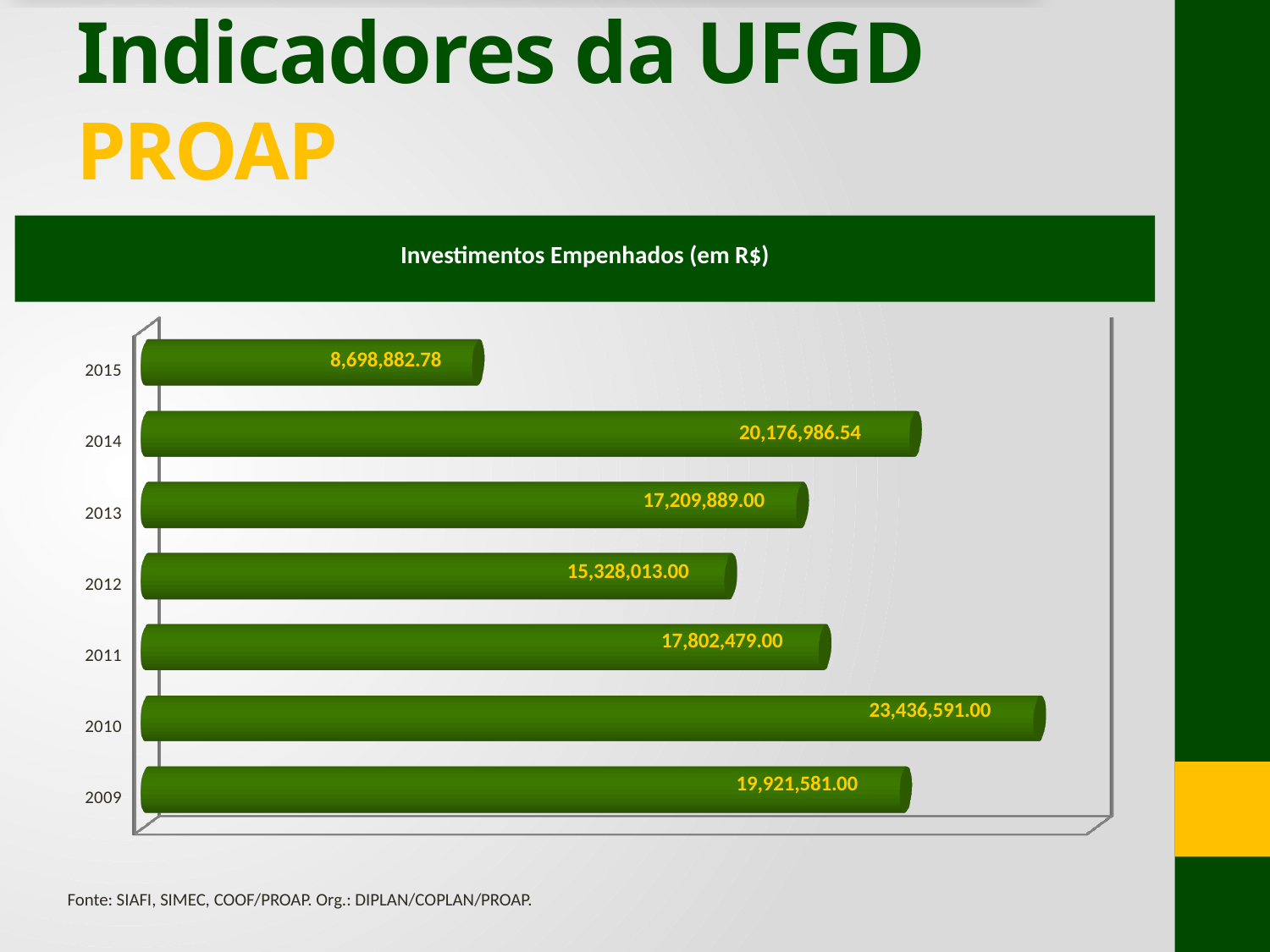
How many years are shown in the Investimentos Empenhados (em R$) chart? 7 What is the value for 2012 in the Investimentos Empenhados (em R$) chart? 15,328,013.00 What is the value for 2015 in the Investimentos Empenhados (em R$) chart? 8,698,882.78 What is the difference between the values for 2014 and 2013 in the Investimentos Empenhados (em R$) chart? 2,967,097.54 Which year has the lowest value in the Investimentos Empenhados (em R$) chart? 2015 Did the value rise or fall from 2014 to 2015 in the Investimentos Empenhados (em R$) chart? Fall What is the value for 2010 in the Investimentos Empenhados (em R$) chart? 23,436,591.00 What is the value for 2009 in the Investimentos Empenhados (em R$) chart? 19,921,581.00 What kind of chart is used to show Investimentos Empenhados (em R$)? Bar chart What is the difference between the values for 2011 and 2012 in the Investimentos Empenhados (em R$) chart? 2,474,466.00 Which is larger in the Investimentos Empenhados (em R$) chart, the value for 2014 or the value for 2009? 2014 Which year has the highest value in the Investimentos Empenhados (em R$) chart? 2010